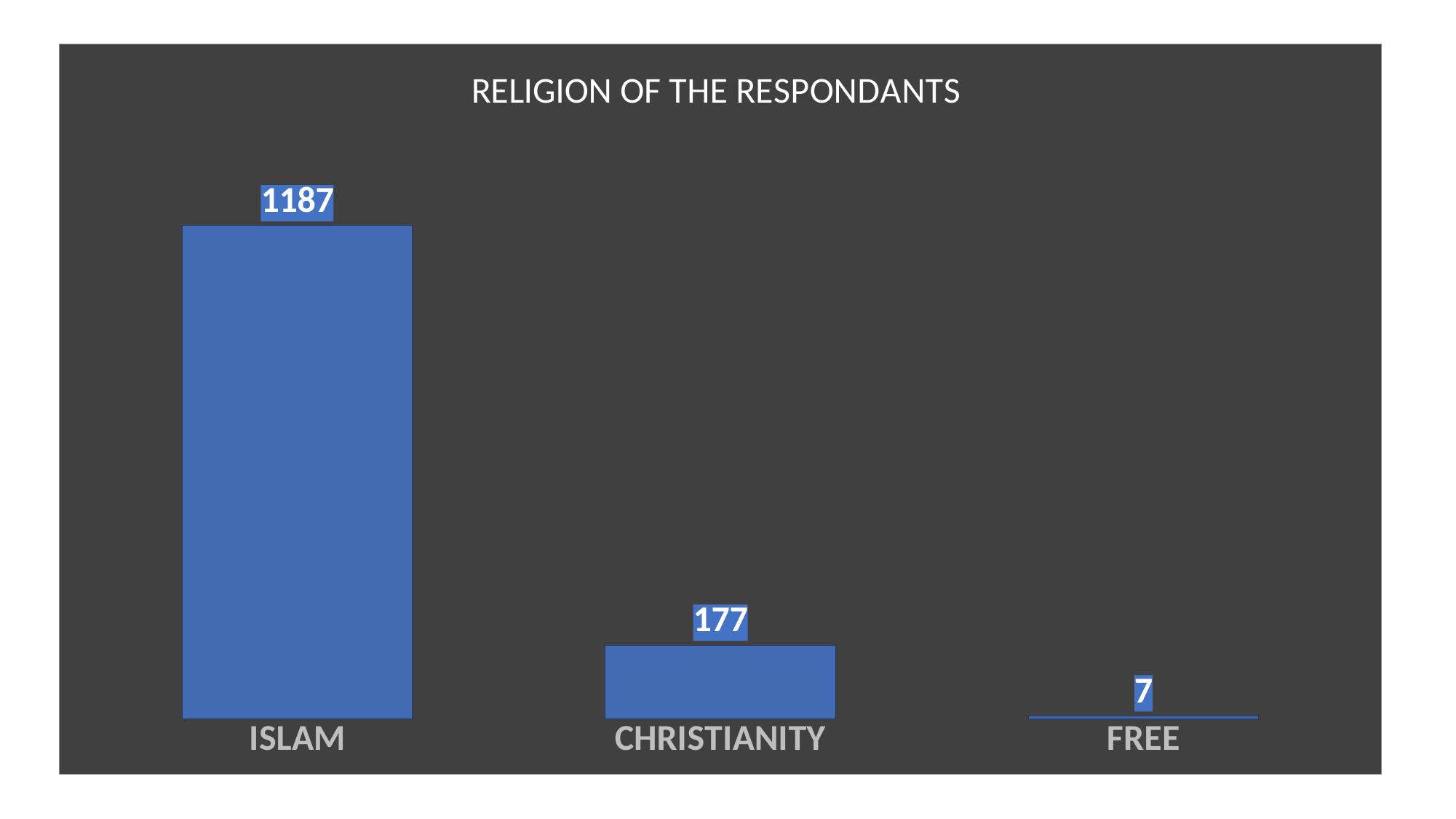
Which category has the highest value? ISLAM What is the difference between the values for ISLAM and CHRISTIANITY? 1010 Do the values rise or fall from left to right across the categories? fall What kind of chart is this? bar chart Which category has the lowest value? FREE How many categories are shown in the chart? 3 What is the value for FREE? 7 Which is larger, the value for CHRISTIANITY or the value for FREE? CHRISTIANITY What is the value for CHRISTIANITY? 177 What is the value for ISLAM? 1187 What is the title of the chart? RELIGION OF THE RESPONDANTS What is the difference between the values for CHRISTIANITY and FREE? 170